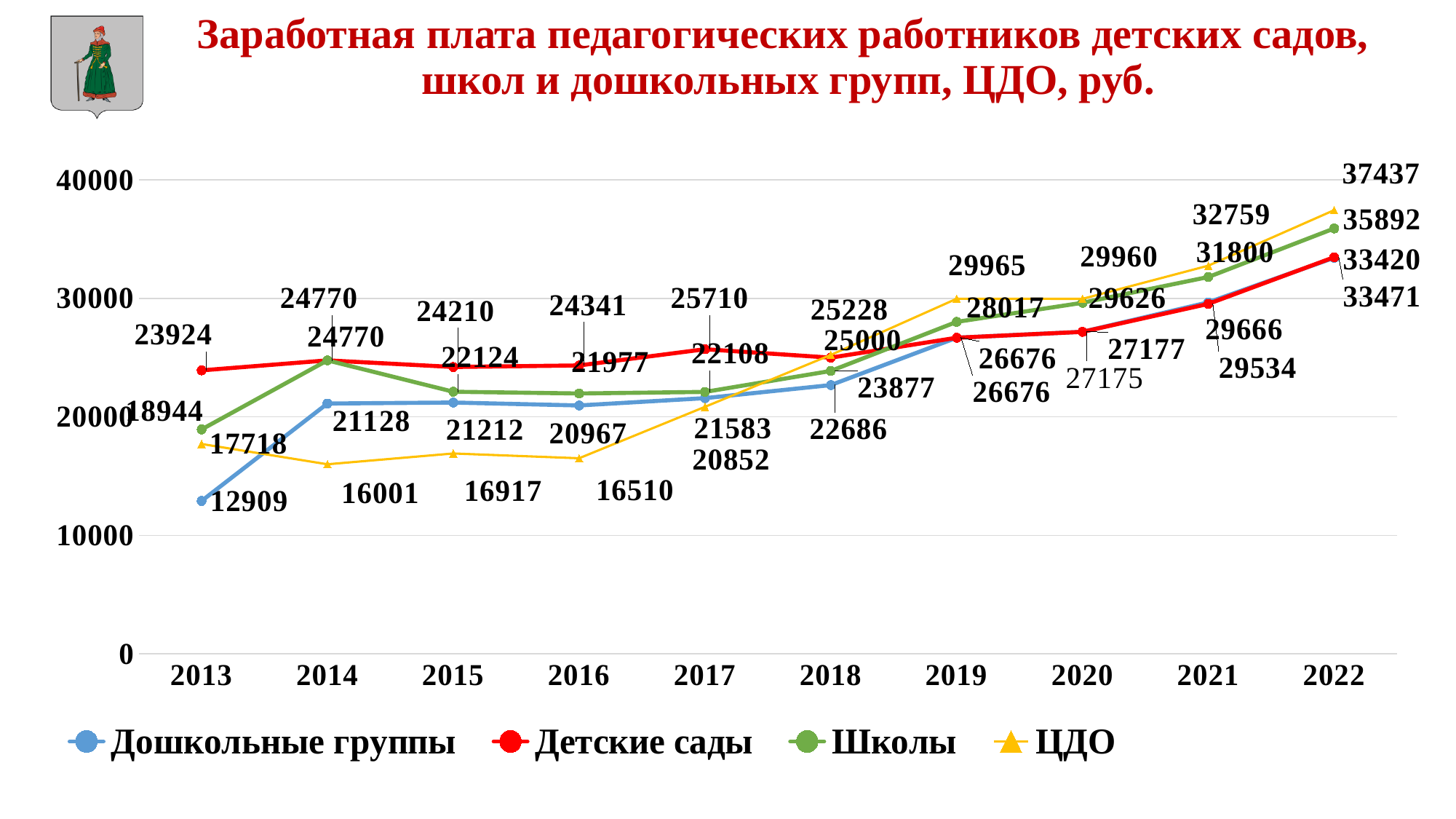
What is the difference between the ЦДО and Школы values in 2022? 1545 What is the value for Дошкольные группы in 2013? 12909 What is the value for ЦДО in 2014? 16001 What is the value for Детские сады in 2013? 23924 How many years are shown on the x axis? 10 What is the value for Школы in 2022? 35892 What is the value for ЦДО in 2022? 37437 Is the value for ЦДО in 2022 greater or less than 30000? greater Which series has the lowest value in 2013? Дошкольные группы How many series does the legend list? 4 What kind of chart is shown on the slide? line chart Which series has the highest value in 2022? ЦДО